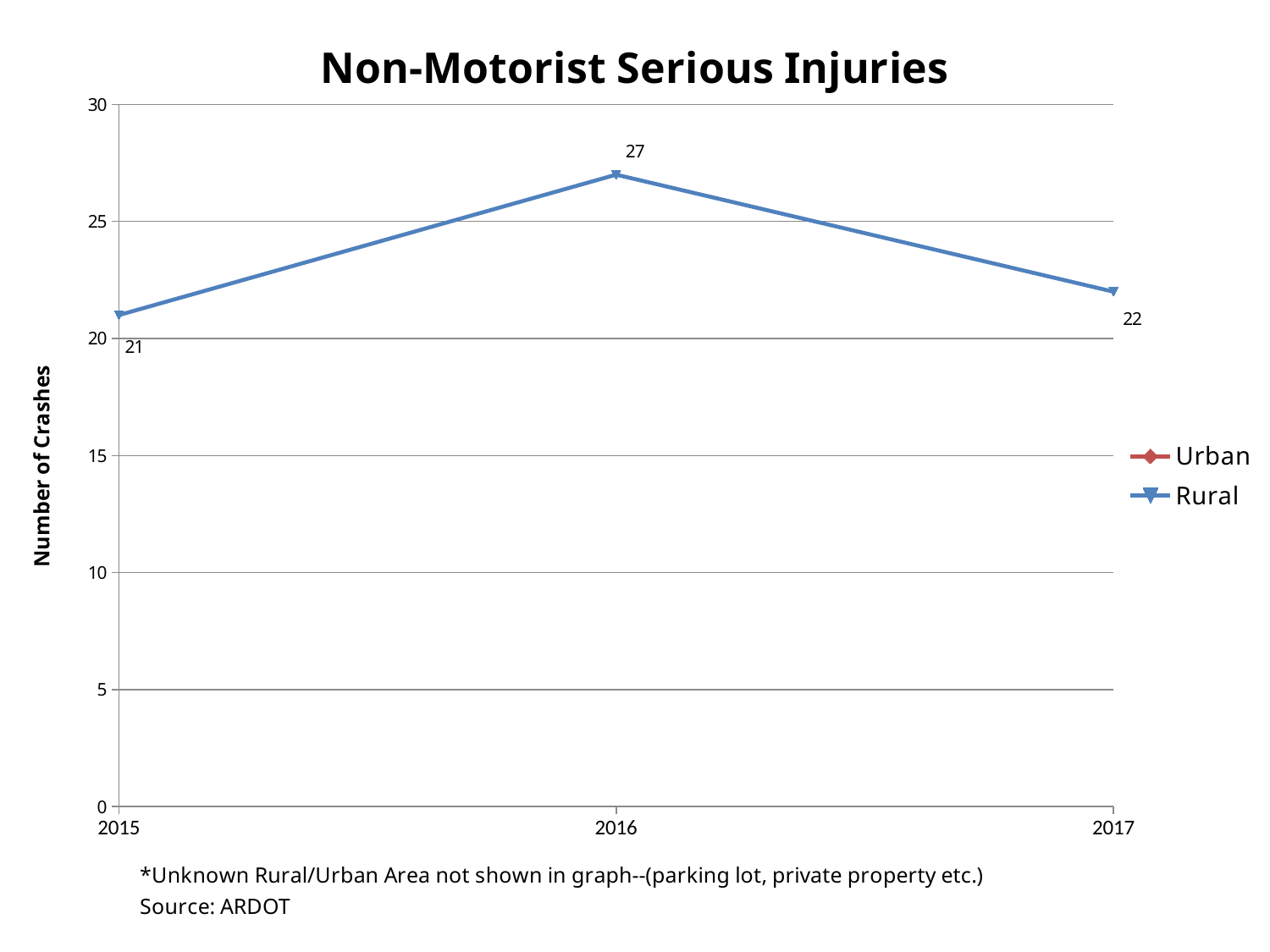
Which year has a larger Rural value, 2015 or 2016? 2016 What is the Rural value for 2017? 22 What is the difference between the Rural values for 2016 and 2017? 5 In which year is the Rural value lowest? 2015 What is the Rural value for 2015? 21 Is the Rural value for 2016 greater or less than 25? greater How many years are shown on the x axis? 3 What is the difference between the Rural values for 2016 and 2015? 6 How many series does the legend list? 2 In which year is the Rural value highest? 2016 What kind of chart is this? line chart What is the Rural value for 2016? 27